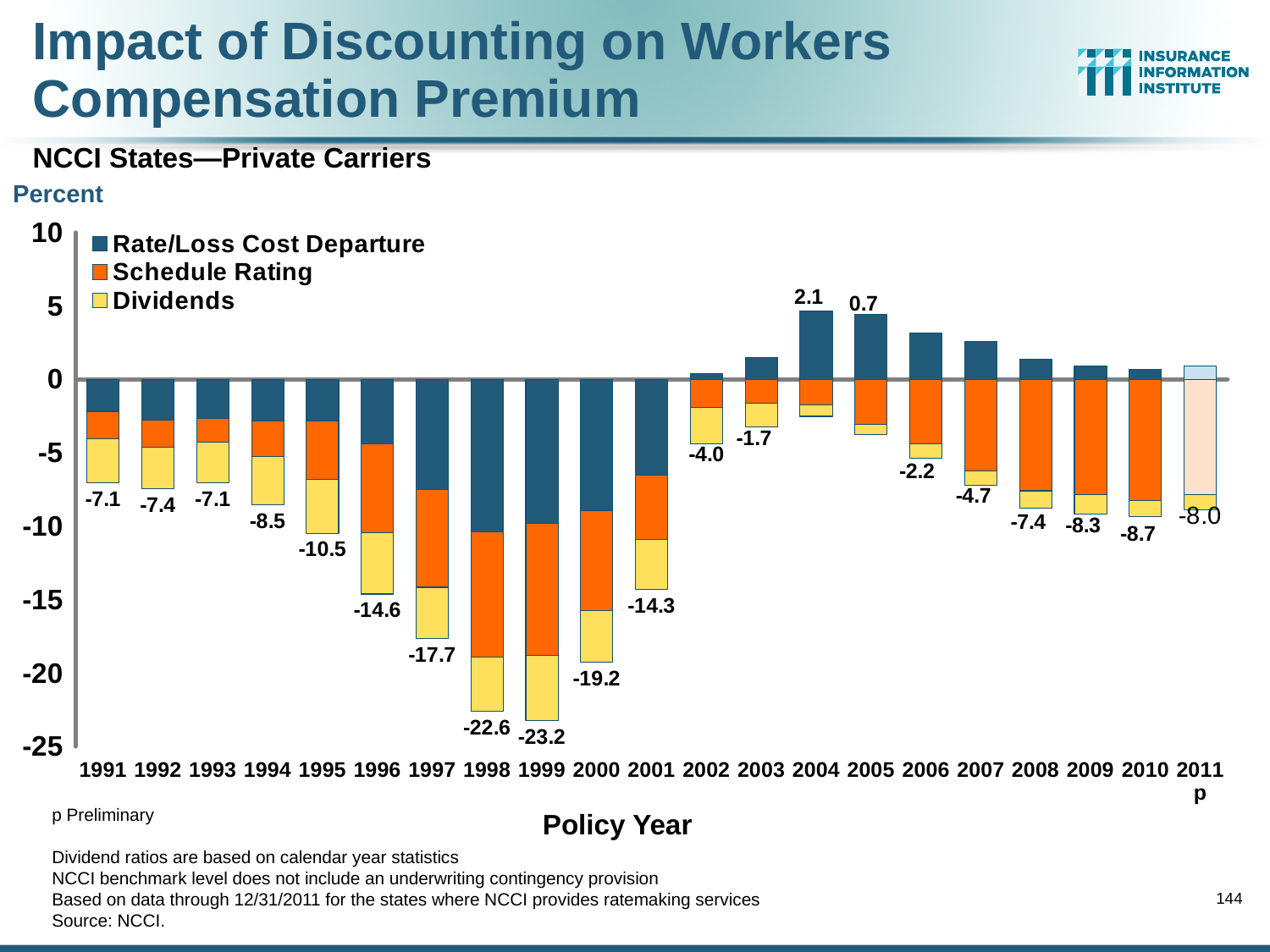
What is the difference between the labeled values for 1999 and 1998? 0.6 What is the labeled value for policy year 2011p? -8.0 What is the labeled value for policy year 1998? -22.6 Which policy year has the highest labeled value? 2004 What is the title of the x axis? Policy Year How many policy years are shown on the x axis? 21 Which policy year has a larger labeled value, 2004 or 2005? 2004 What kind of chart is shown on the slide? Stacked bar chart Which policy year has the lowest labeled value? 1999 How many series does the legend list? 3 Do the labeled values rise or fall from 1995 to 1999? Fall What is the labeled value for policy year 2004? 2.1